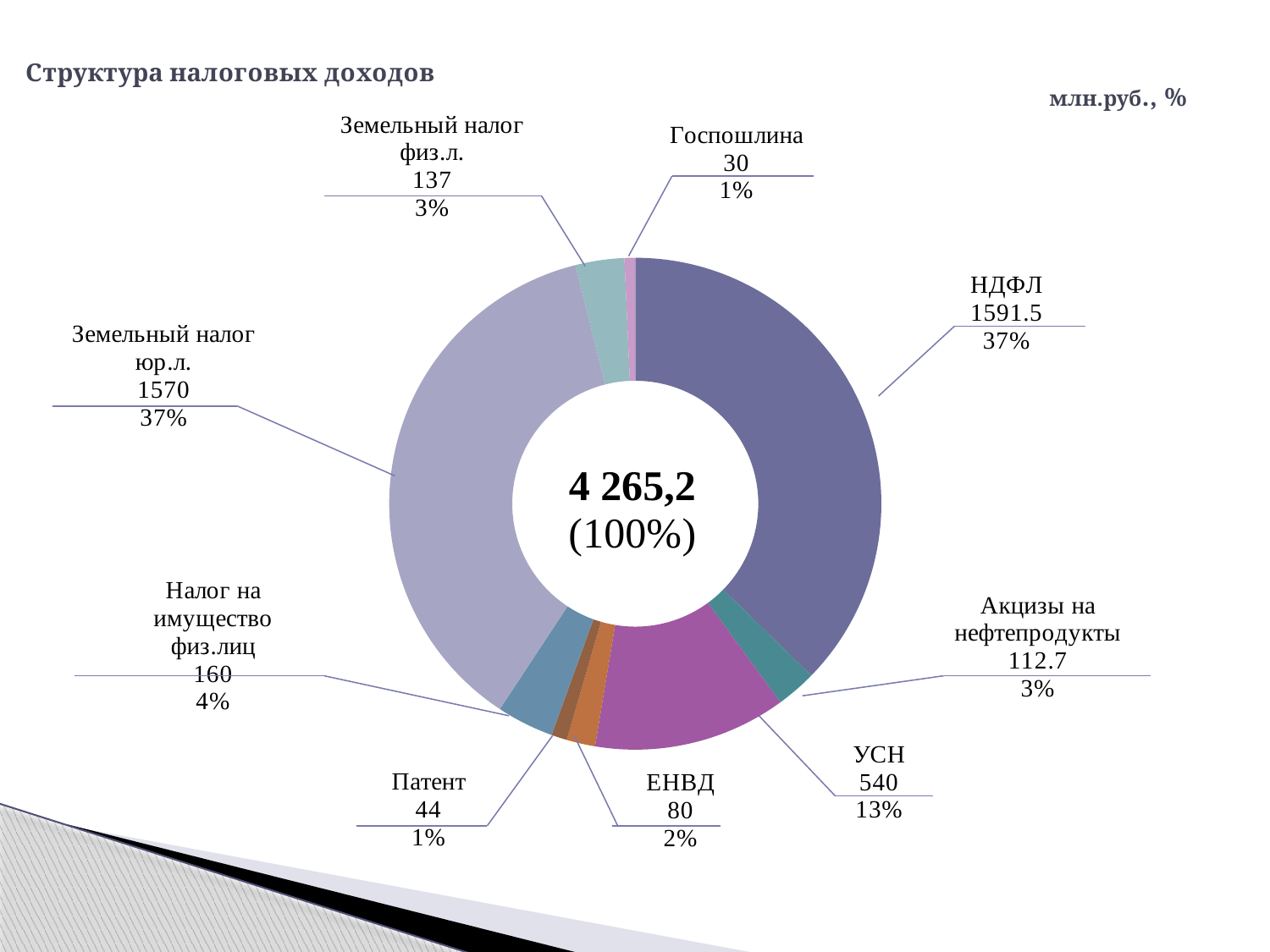
What is the value for Акцизы на нефтепродукты? 112.7 Which category has the lowest value? Госпошлина What total value is printed in the centre of the chart? 4 265,2 (100%) How many categories are shown in the chart? 9 What share of the total does Земельный налог юр.л. represent? 37% What is the value for НДФЛ? 1591.5 What share of the total does ЕНВД represent? 2% What is the difference between the values for Налог на имущество физ.лиц and Земельный налог физ.л.? 23 What kind of chart is shown on the slide? Doughnut (pie) chart What is the value for УСН? 540 Which is larger, the value for Патент or the value for ЕНВД? ЕНВД Which category has the highest value according to the printed labels? НДФЛ